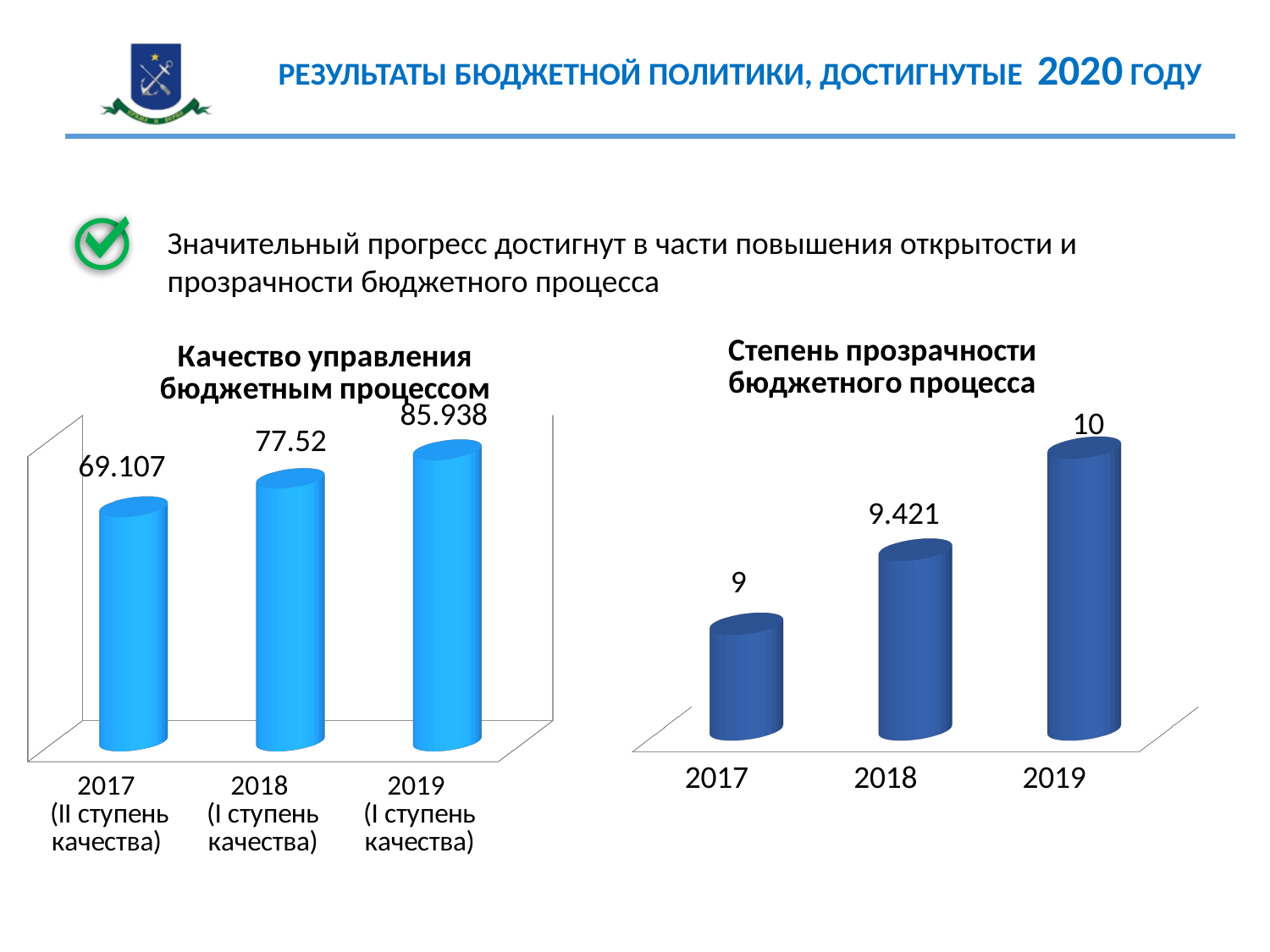
In the chart 'Степень прозрачности бюджетного процесса', what is the difference between the 2019 and 2017 values? 1 In the chart 'Качество управления бюджетным процессом', which is larger: the value for 2018 or the value for 2017? 2018 In the chart 'Качество управления бюджетным процессом', what is the value for 2017? 69.107 In the chart 'Качество управления бюджетным процессом', which year has the lowest value? 2017 How many bars are shown in the chart 'Степень прозрачности бюджетного процесса'? 3 What type of chart is 'Качество управления бюджетным процессом'? Bar chart What is the title of the chart on the right side of the slide? Степень прозрачности бюджетного процесса In the chart 'Степень прозрачности бюджетного процесса', do the values rise or fall from 2017 to 2019? Rise In the chart 'Степень прозрачности бюджетного процесса', which year has the highest value? 2019 In the chart 'Качество управления бюджетным процессом', what is the value for 2019? 85.938 In the chart 'Качество управления бюджетным процессом', what is the difference between the 2019 and 2017 values? 16.831 In the chart 'Степень прозрачности бюджетного процесса', what is the value for 2018? 9.421